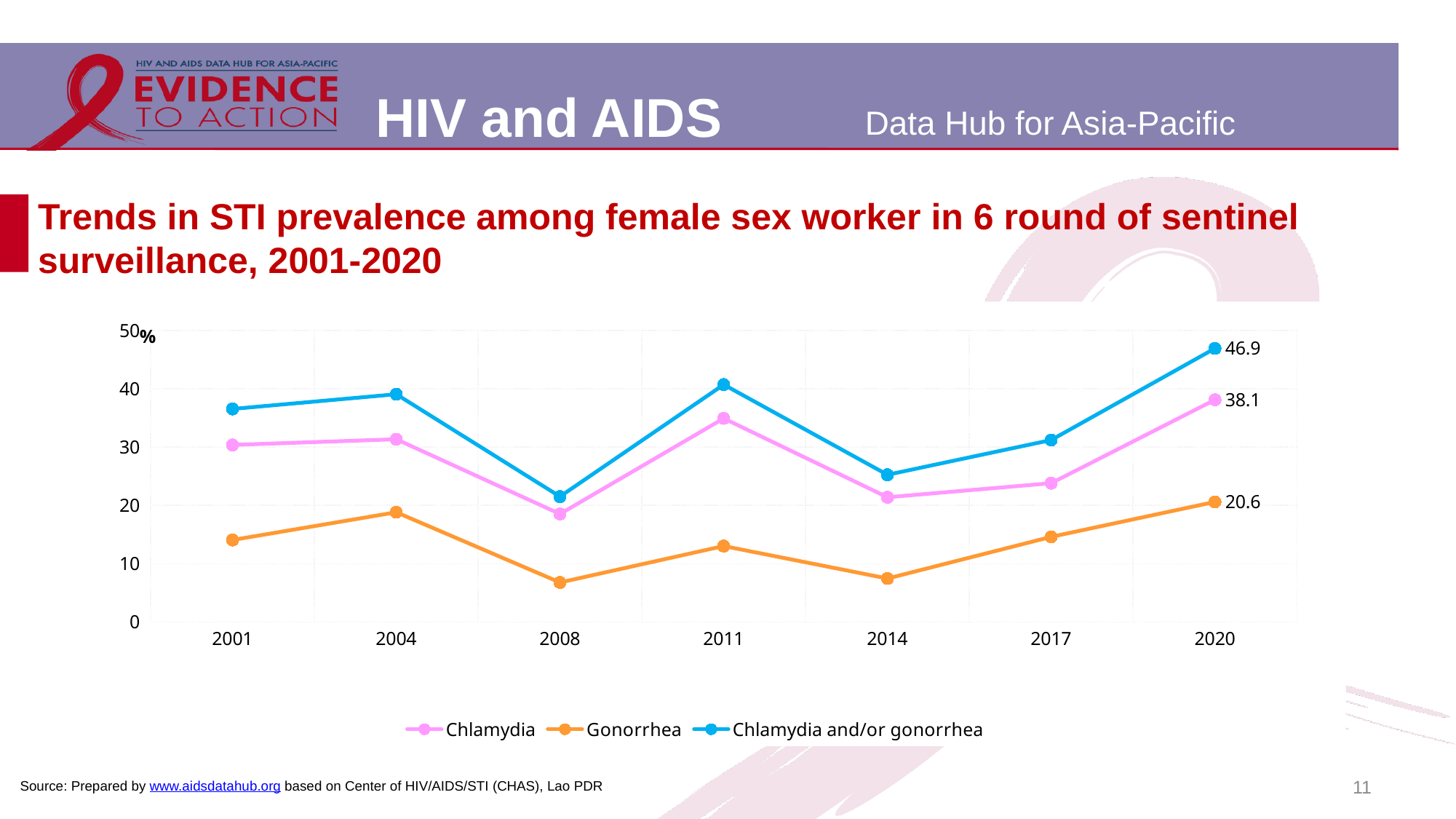
How many survey years are shown on the x axis? 7 What is the difference between the Chlamydia and/or gonorrhea value and the Chlamydia value in 2020? 8.8 What is the difference between the Chlamydia value and the Gonorrhea value in 2020? 17.5 How many series does the legend list? 3 In which year is the Chlamydia series at its lowest? 2008 Is the value for Chlamydia in 2011 greater or less than 30? greater In which year is the Chlamydia and/or gonorrhea series at its highest? 2020 What kind of chart is shown on the slide? line chart What is the value for Gonorrhea in 2020? 20.6 Is the value for Gonorrhea in 2004 greater or less than 20? less What is the value for Chlamydia in 2020? 38.1 What is the value for Chlamydia and/or gonorrhea in 2020? 46.9